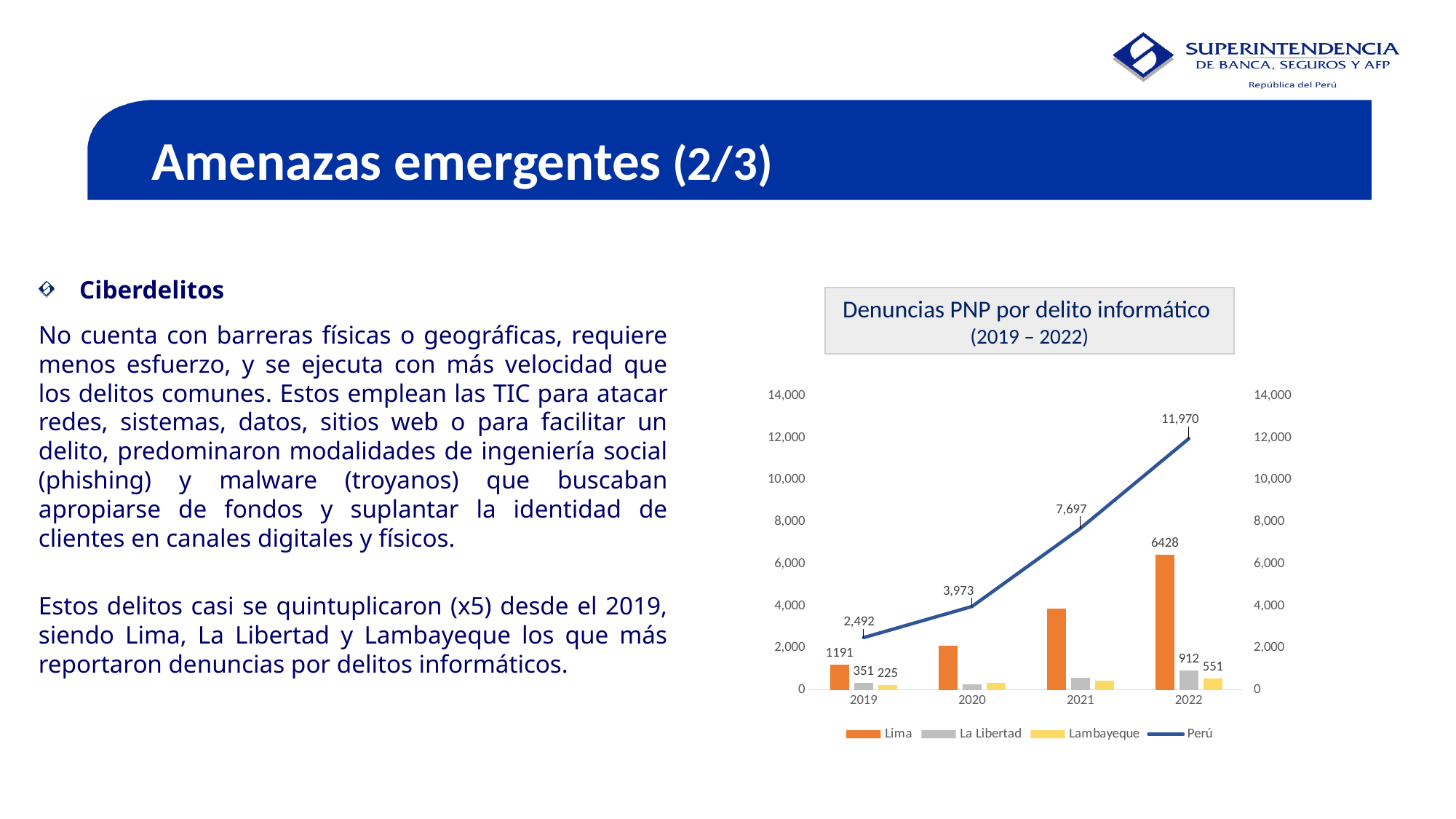
Does the Perú line rise or fall from 2019 to 2022? rises What is the difference between the Lima values for 2022 and 2019? 5237 What is the value for La Libertad in 2022? 912 What is the value of the Perú line for 2020? 3,973 How many series does the legend list? 4 Which is larger: the Lima value for 2022 or the Perú value for 2021? Perú value for 2021 By how much did the Perú value increase from 2019 to 2022? 9,478 What is the value for Lambayeque in 2019? 225 In which year is the Perú line at its highest? 2022 What is the value for Lima in 2019? 1191 Is the value for Lima in 2021 greater or less than 2,000? greater What is the value of the Perú line for 2022? 11,970